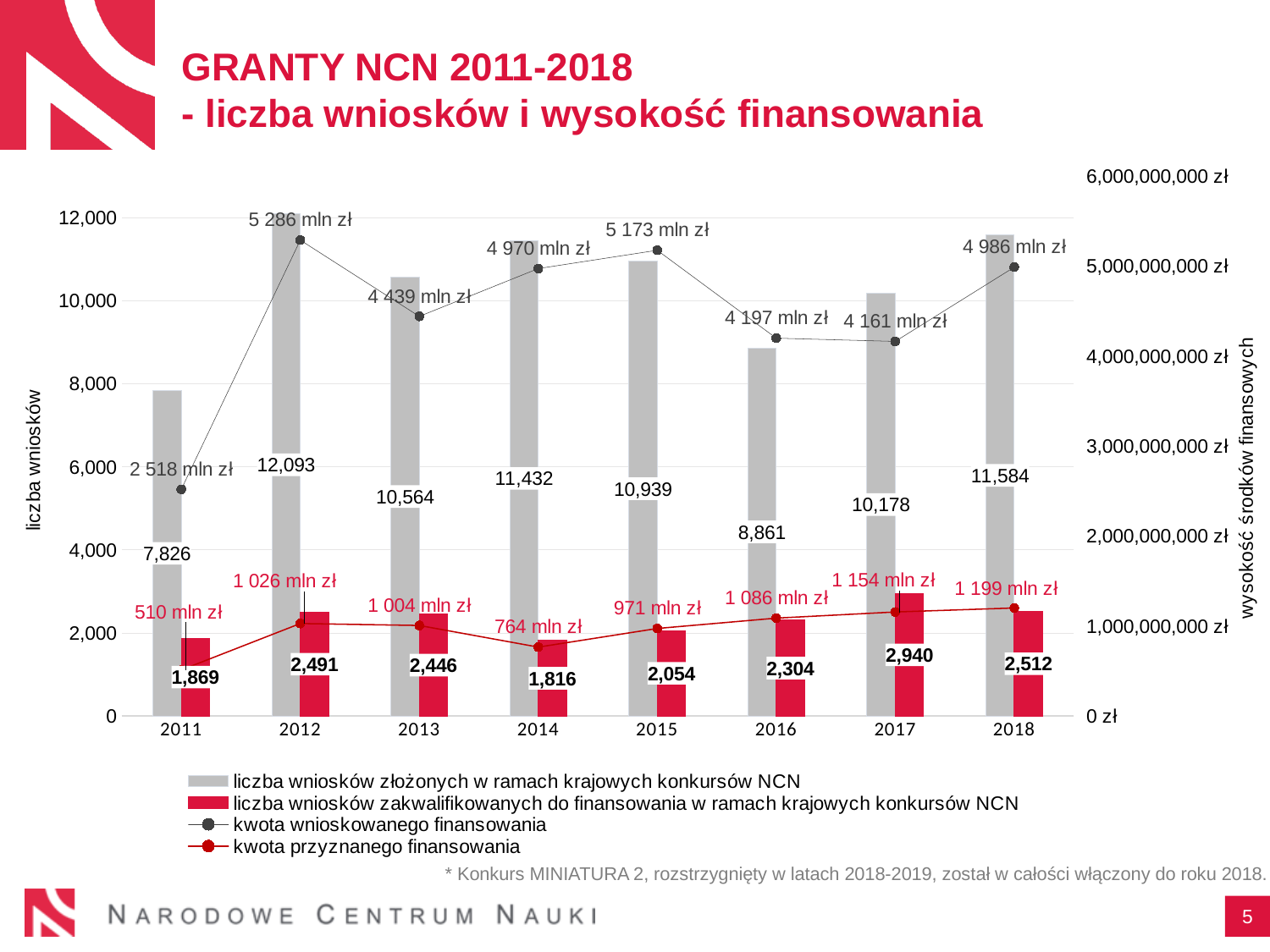
How many applications were submitted in national NCN competitions (liczba wniosków złożonych) in 2012? 12,093 In which year was the number of qualified applications the lowest? 2014 Which year had a larger amount of awarded funding, 2013 or 2016? 2016 What was the amount of awarded funding (kwota przyznanego finansowania) in 2011? 510 mln zł Did the amount of awarded funding rise or fall between 2016 and 2018? rise What is the difference between the number of submitted applications in 2018 and in 2016? 2,723 How many years are shown on the x axis of the chart? 8 How many series does the legend list? 4 In which year was the number of submitted applications the highest? 2012 What was the amount of requested funding (kwota wnioskowanego finansowania) in 2015? 5 173 mln zł What colour are the bars for applications qualified for funding? red How many applications were qualified for funding (liczba wniosków zakwalifikowanych) in 2017? 2,940